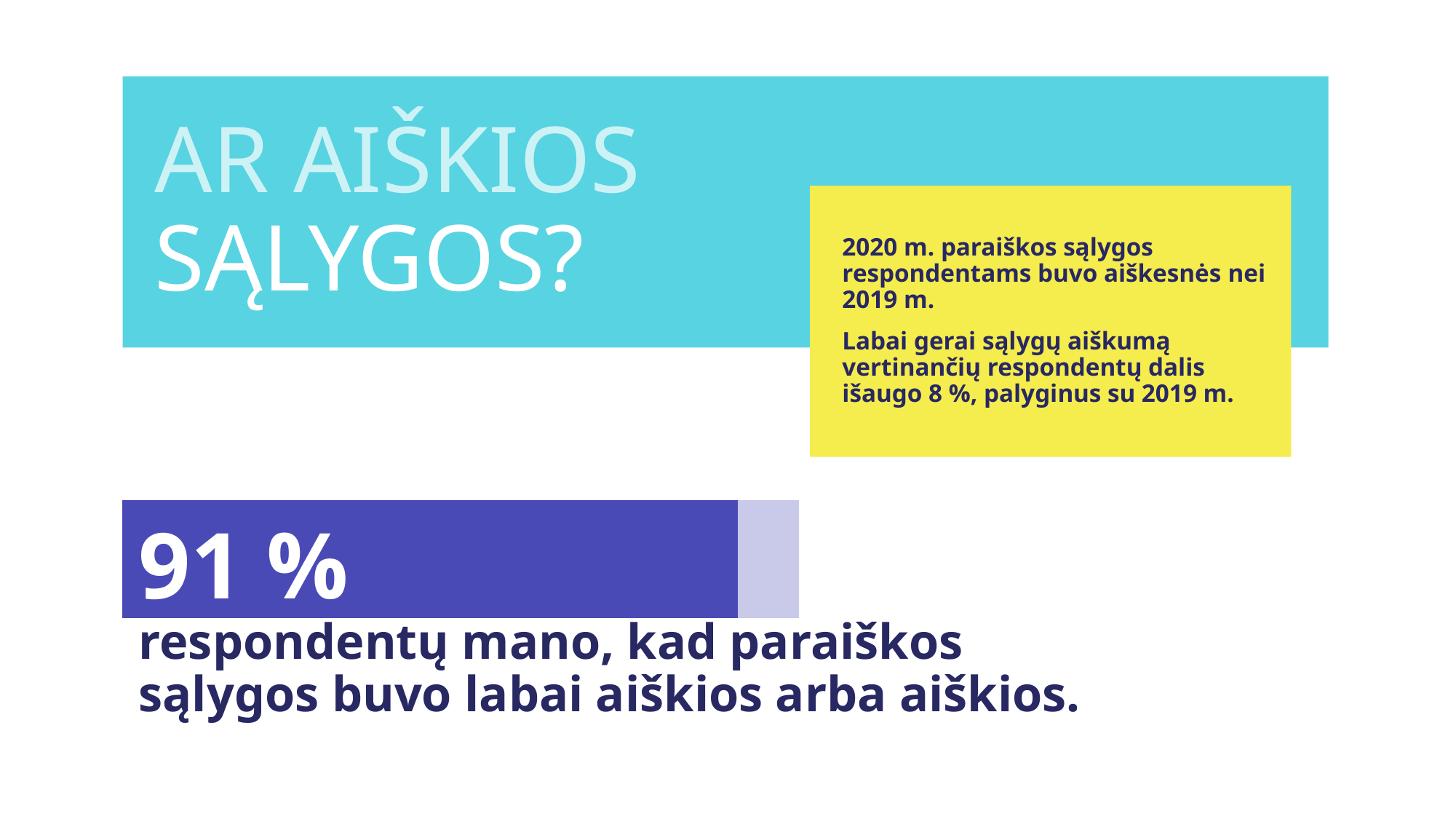
What colour is the filled portion of the bar? dark blue What share of respondents think the application conditions were very clear or clear, according to the bar? 91 % What percentage value is shown on the bar on the slide? 91 % How many bars are plotted on the slide? 1 What kind of chart is shown at the bottom of the slide? bar chart What is the title of the slide containing the bar? AR AIŠKIOS SĄLYGOS? Is the filled portion of the bar larger or smaller than the unfilled portion? larger